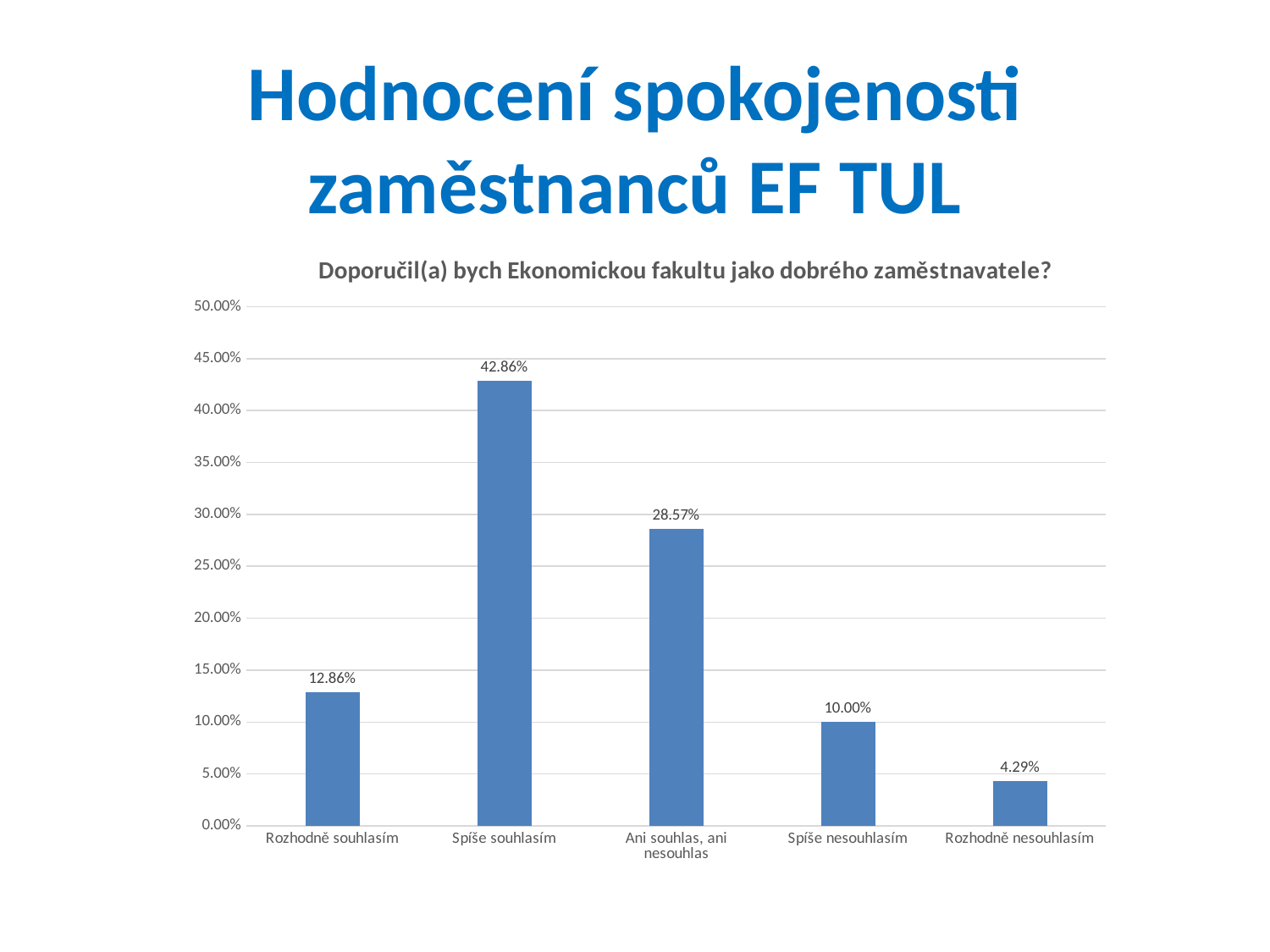
Which category has the lowest value? Rozhodně nesouhlasím Which category has the highest value? Spíše souhlasím What is the difference between the values for "Spíše souhlasím" and "Ani souhlas, ani nesouhlas"? 14.29% How many categories are shown on the x axis? 5 What is the value for "Spíše souhlasím"? 42.86% Which is larger, the value for "Rozhodně souhlasím" or the value for "Spíše nesouhlasím"? Rozhodně souhlasím What is the difference between the values for "Spíše nesouhlasím" and "Rozhodně nesouhlasím"? 5.71% What kind of chart is shown on the slide? bar chart What is the value for "Rozhodně nesouhlasím"? 4.29% Is the value for "Ani souhlas, ani nesouhlas" greater or less than 25.00%? greater What is the value for "Ani souhlas, ani nesouhlas"? 28.57% What is the title of the chart? Doporučil(a) bych Ekonomickou fakultu jako dobrého zaměstnavatele?